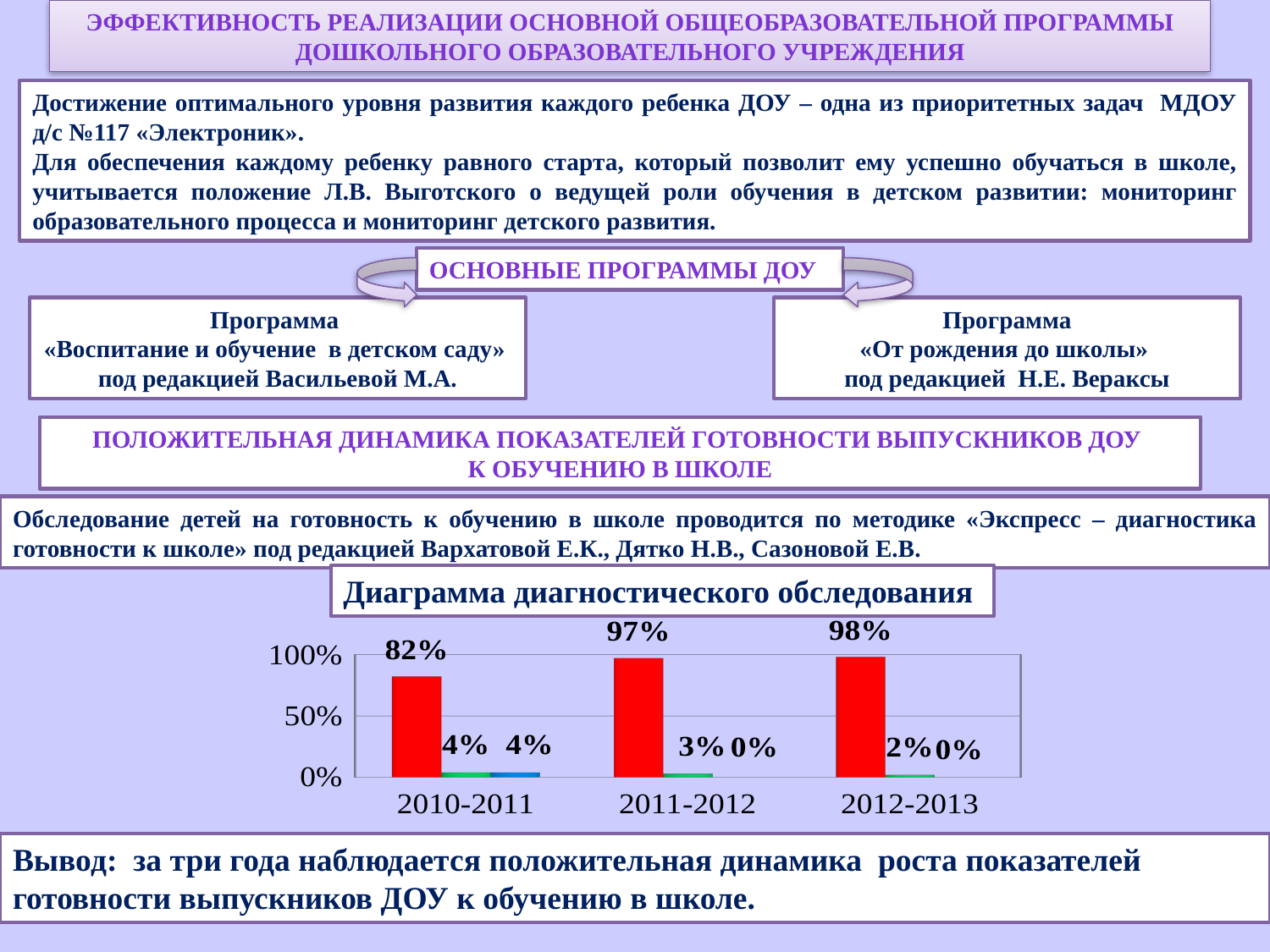
What is the value of the red bar for 2011-2012? 97% What type of chart is shown under the title "Диаграмма диагностического обследования"? bar chart In which year category is the red bar the highest? 2012-2013 What is the difference between the red bar values for 2012-2013 and 2010-2011? 16% What is the value of the green bar for 2012-2013? 2% How many year categories are shown on the x axis of the chart? 3 What is the title shown above the chart? Диаграмма диагностического обследования What is the value of the red bar for 2010-2011? 82% What is the value of the green bar for 2011-2012? 3% Do the red bar values rise or fall from 2010-2011 to 2012-2013? rise What is the value of the red bar for 2012-2013? 98% In which year category is the red bar the lowest? 2010-2011